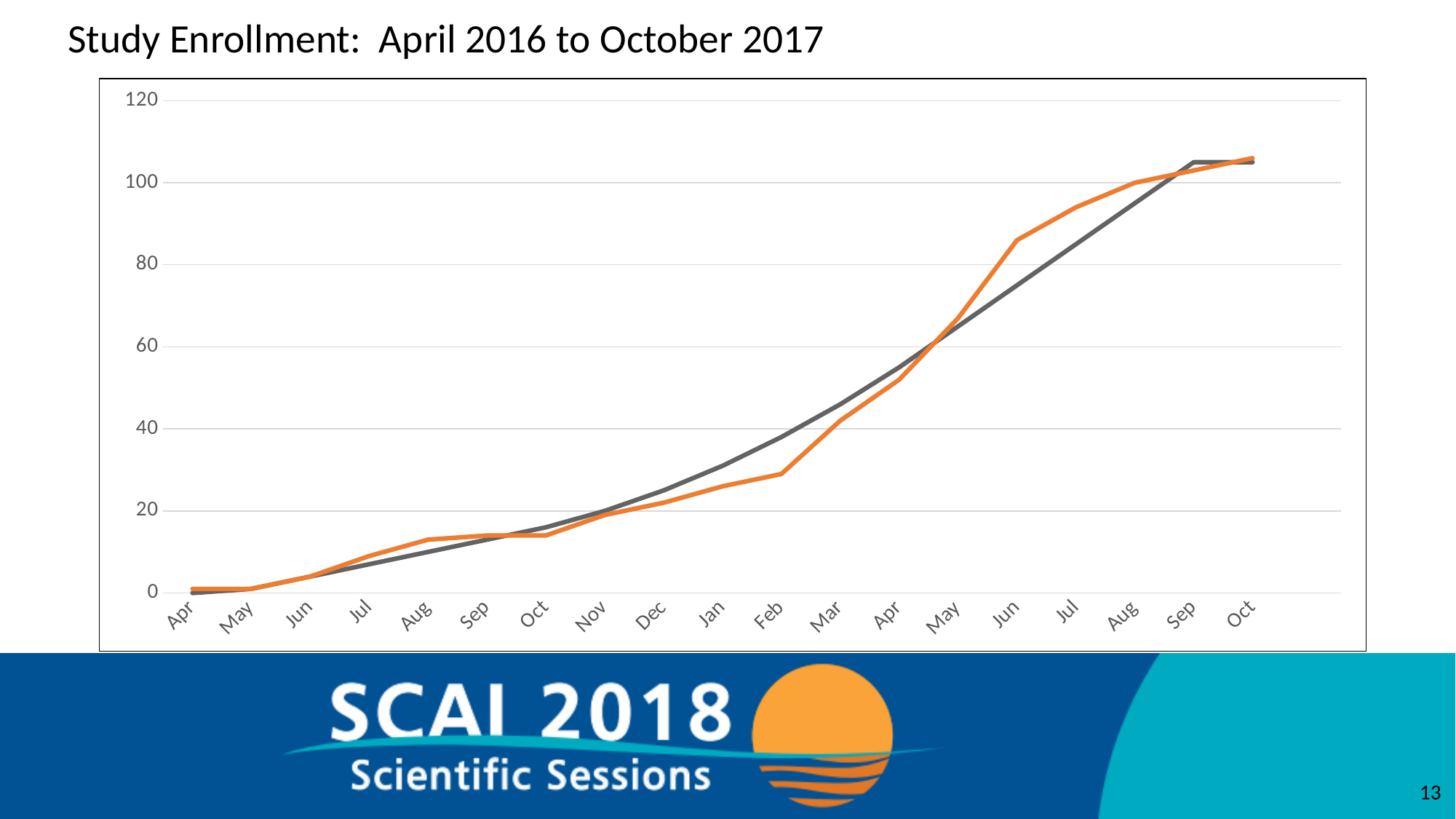
What kind of chart is shown on the slide? line chart How many lines are plotted on the chart? 2 Is the value of the orange line at the final Oct (2017) greater or less than 100? greater Do the values of the orange line generally rise or fall from April 2016 to October 2017? rise What is the highest value shown on the y axis of the chart? 120 What is the title of the slide containing the chart? Study Enrollment: April 2016 to October 2017 How many month labels are shown along the x axis of the chart? 19 Is the value of the orange line at Feb greater or less than 40? less At Feb, which line has the higher value, the orange line or the gray line? gray line At the second Jun (2017), which line has the higher value, the orange line or the gray line? orange line Is the value of the gray line at the second Jun (2017) greater or less than 80? less